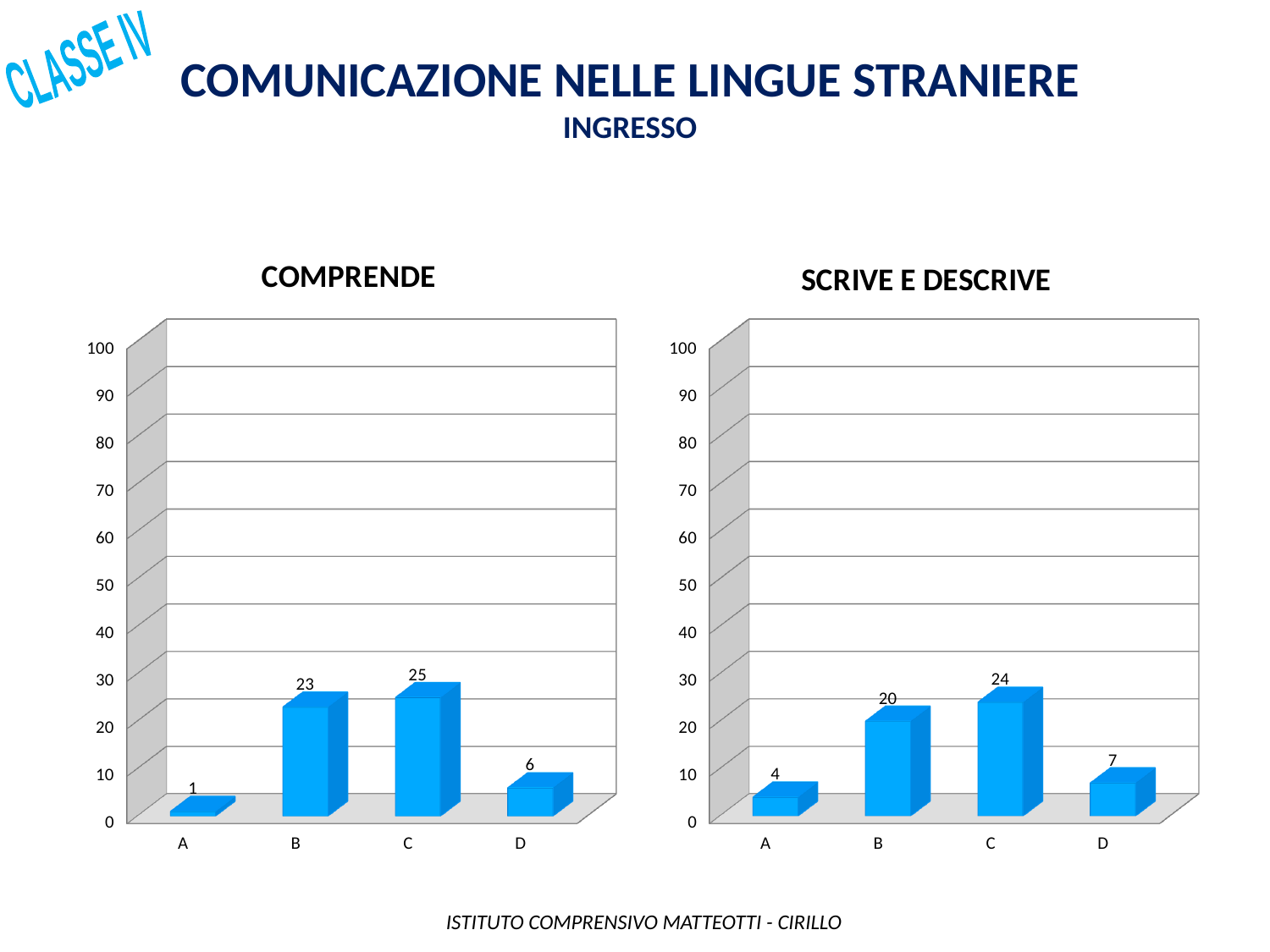
In the COMPRENDE chart, what is the difference between the values for C and D? 19 In the SCRIVE E DESCRIVE chart, what is the value for category A? 4 In the SCRIVE E DESCRIVE chart, which category has the lowest value? A In the COMPRENDE chart, is the value for C greater or less than 30? less How many categories are shown on the x axis of the SCRIVE E DESCRIVE chart? 4 In the COMPRENDE chart, what is the value for category B? 23 In the SCRIVE E DESCRIVE chart, which is larger, the value for B or the value for D? B In the SCRIVE E DESCRIVE chart, what is the value for category D? 7 In the COMPRENDE chart, which category has the highest value? C In the SCRIVE E DESCRIVE chart, what is the difference between the values for C and B? 4 What kind of chart is the COMPRENDE chart? bar chart In the COMPRENDE chart, what is the value for category A? 1